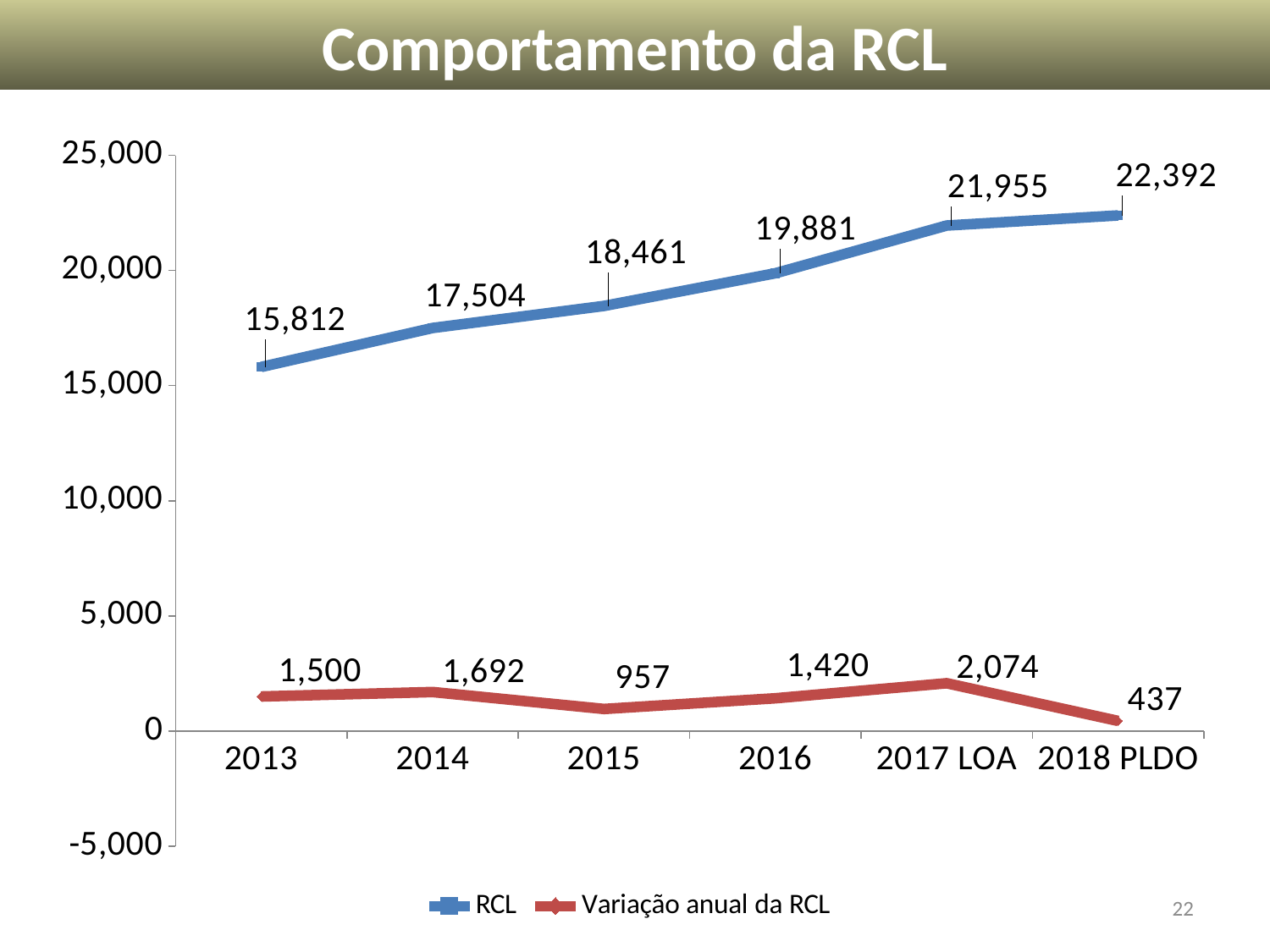
In which year is Variação anual da RCL lowest? 2018 PLDO What is the RCL value for 2018 PLDO? 22,392 Does the RCL series rise or fall from 2013 to 2018 PLDO? rise How many series does the legend list? 2 Is the RCL value for 2016 greater or less than 20,000? less In which year is RCL highest? 2018 PLDO Which is larger, Variação anual da RCL in 2014 or in 2016? 2014 What is the value of Variação anual da RCL for 2017 LOA? 2,074 What kind of chart is shown? line chart What is the RCL value for 2015? 18,461 How many points are plotted along the x axis for each series? 6 What is the difference between the RCL values for 2014 and 2013? 1,692